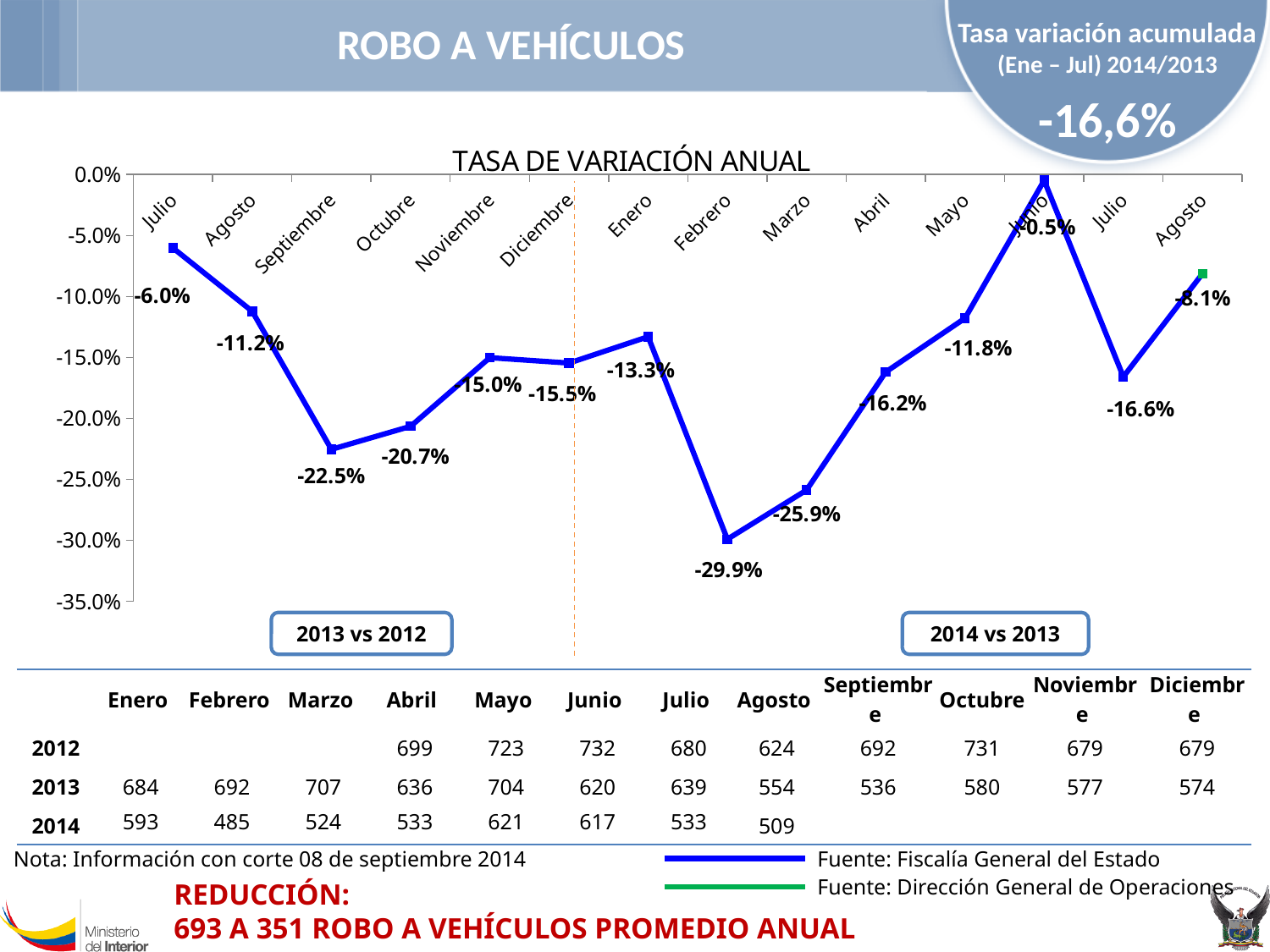
What type of chart is shown under the title TASA DE VARIACIÓN ANUAL? line chart In the TASA DE VARIACIÓN ANUAL chart, do the values rise or fall from Enero to Febrero? fall In the TASA DE VARIACIÓN ANUAL chart, what is the difference between the values for Marzo and Abril? 9.7 percentage points In the TASA DE VARIACIÓN ANUAL chart, what is the value for Febrero? -29.9% In the TASA DE VARIACIÓN ANUAL chart, which is larger, the value for Octubre or the value for Noviembre? Noviembre In the TASA DE VARIACIÓN ANUAL chart, what is the value for the last point, Agosto in the 2014 vs 2013 section? -8.1% What accumulated variation rate (Ene – Jul) 2014/2013 is shown in the circle at the top right of the slide? -16,6% How many data points are plotted in the TASA DE VARIACIÓN ANUAL chart? 14 In the TASA DE VARIACIÓN ANUAL chart, what is the value for Mayo? -11.8% In the TASA DE VARIACIÓN ANUAL chart, what is the value for Septiembre? -22.5% In the TASA DE VARIACIÓN ANUAL chart, which month has the highest value? Junio In the TASA DE VARIACIÓN ANUAL chart, which month has the lowest value? Febrero